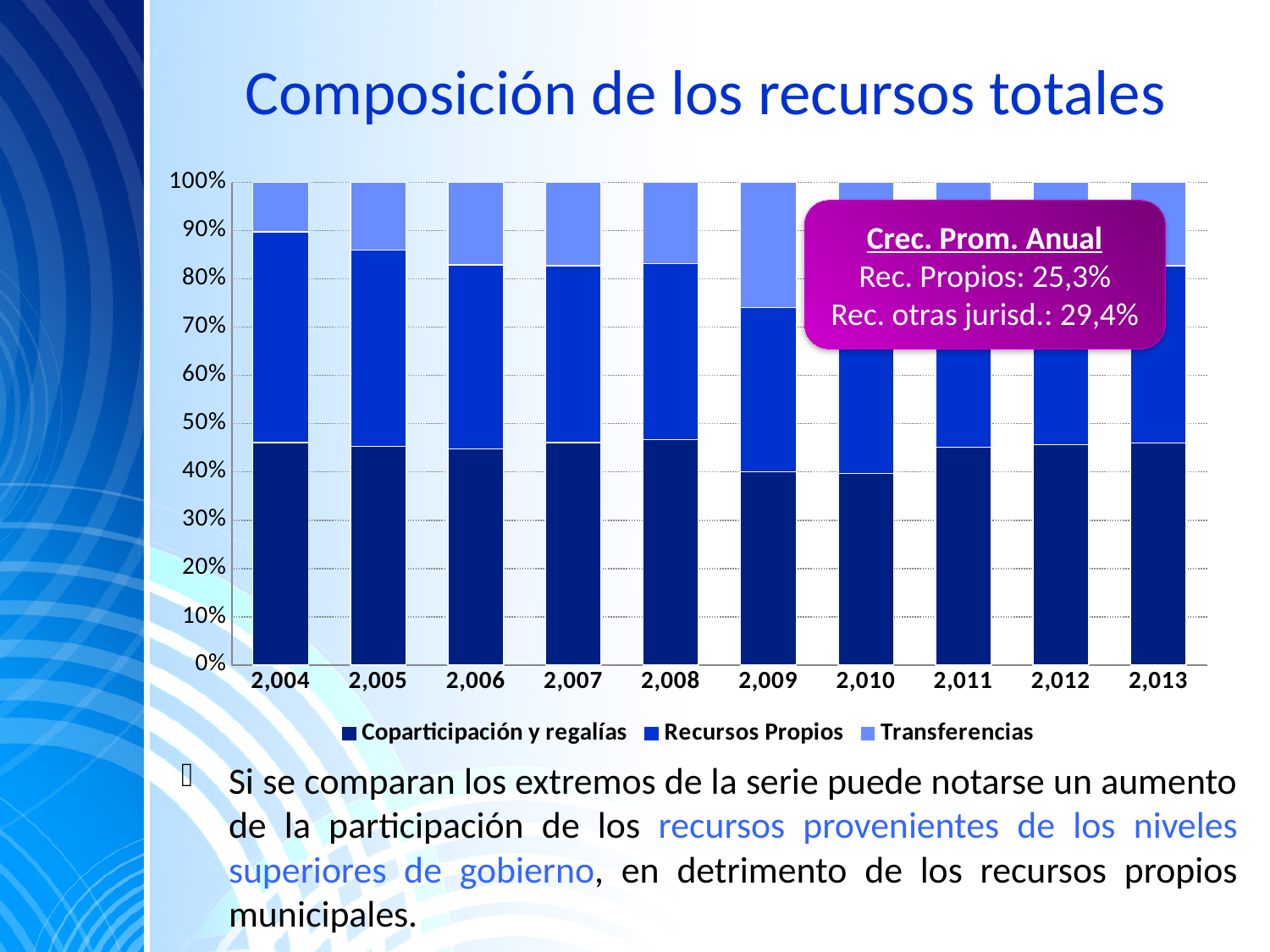
Is the share of Transferencias in 2,004 greater or less than 20%? less Is the share of Transferencias in 2,009 greater or less than 20%? greater What kind of chart is shown on the slide? Stacked bar chart Is the share of Coparticipación y regalías in 2,009 greater or less than 50%? less What is the title of the chart? Composición de los recursos totales How many series does the chart legend list? 3 Which year has the larger share of Transferencias, 2,004 or 2,009? 2,009 Which series is listed first in the chart legend? Coparticipación y regalías How many years are shown on the x axis of the chart? 10 Which year has the larger share of Coparticipación y regalías, 2,008 or 2,009? 2,008